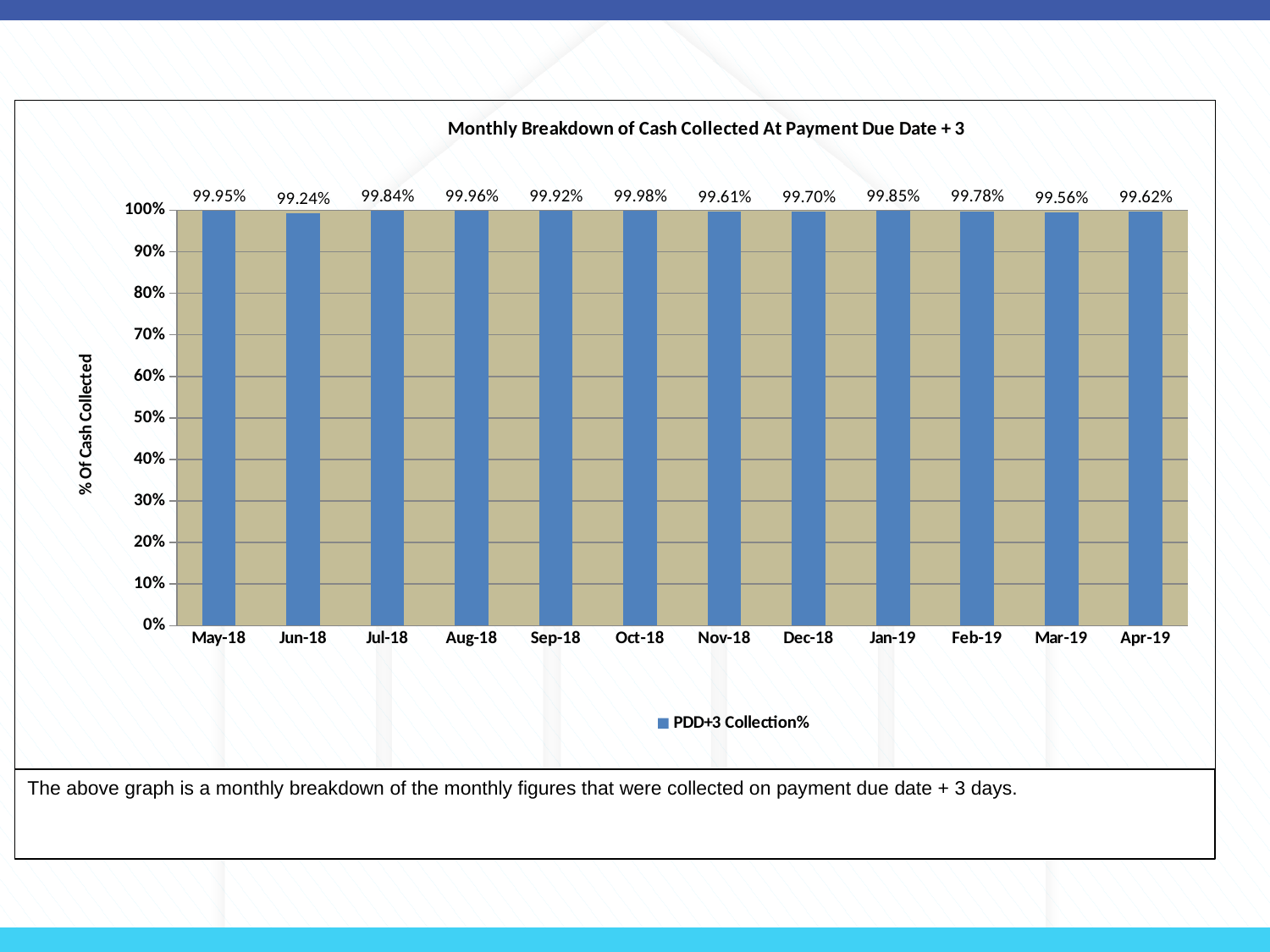
Which month has the highest PDD+3 Collection% according to the data labels? Oct-18 What is the PDD+3 Collection% value for Oct-18? 99.98% What is the difference between the PDD+3 Collection% for Oct-18 and Jun-18? 0.74% Which month has the lowest PDD+3 Collection% according to the data labels? Jun-18 How many months are shown on the x axis of the chart? 12 How many series does the legend list? 1 Which has a higher PDD+3 Collection%, Nov-18 or Dec-18? Dec-18 What is the PDD+3 Collection% value for Apr-19? 99.62% What is the PDD+3 Collection% value for Jun-18? 99.24% What is the title of the chart? Monthly Breakdown of Cash Collected At Payment Due Date + 3 What kind of chart is shown on the slide? Bar chart What is the PDD+3 Collection% value for Jan-19? 99.85%